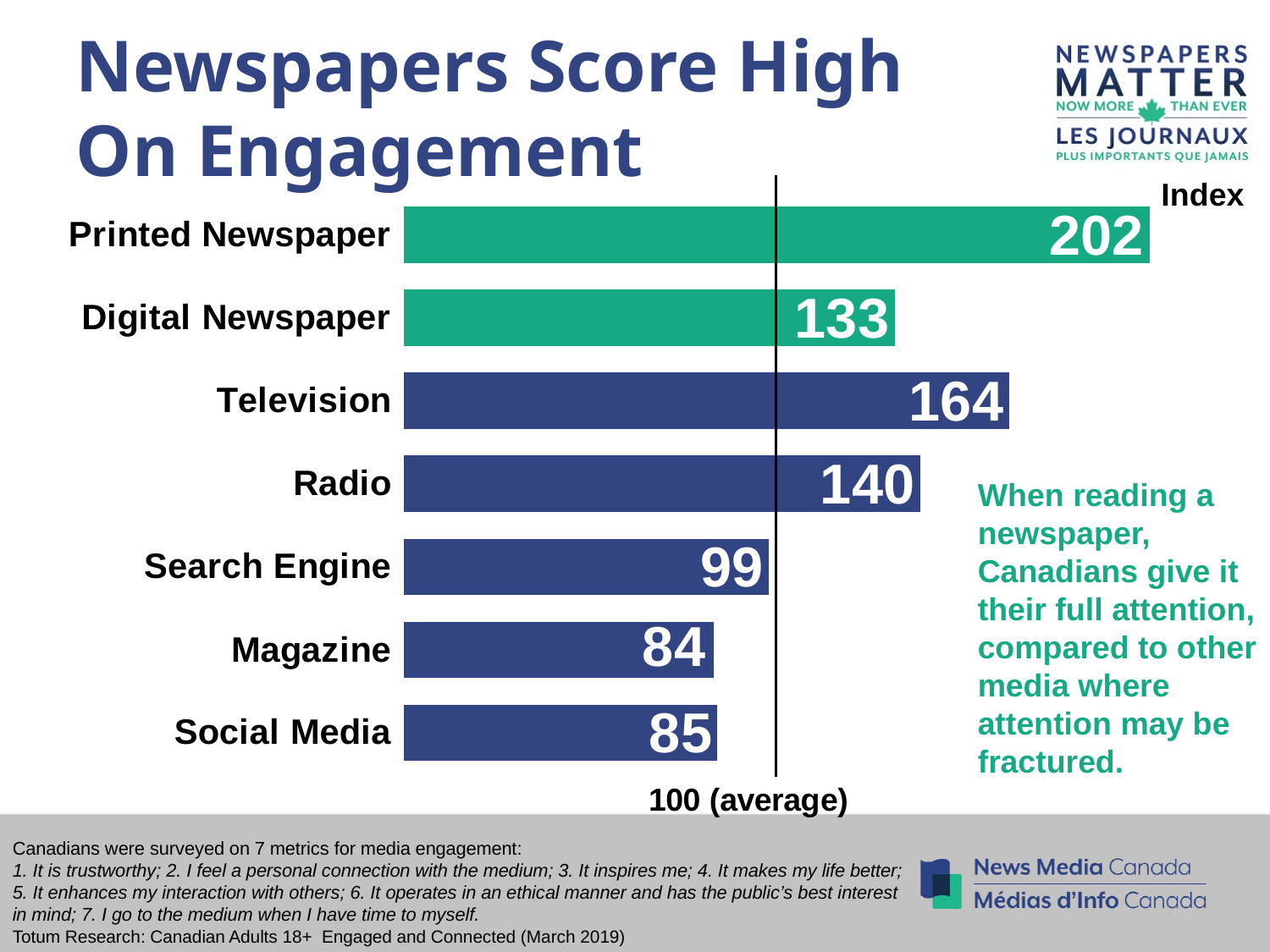
What is the difference between the index values for Television and Radio? 24 What is the engagement index value for Television? 164 How many media categories are shown in the chart? 7 Which medium has the highest engagement index? Printed Newspaper What value does the vertical reference line in the chart represent? 100 (average) Which has a higher engagement index, Social Media or Magazine? Social Media Which medium has the lowest engagement index? Magazine What is the engagement index value for Printed Newspaper? 202 What is the difference between the index values for Printed Newspaper and Digital Newspaper? 69 What kind of chart is shown on the slide? Bar chart What is the engagement index value for Search Engine? 99 Which has a higher engagement index, Radio or Digital Newspaper? Radio